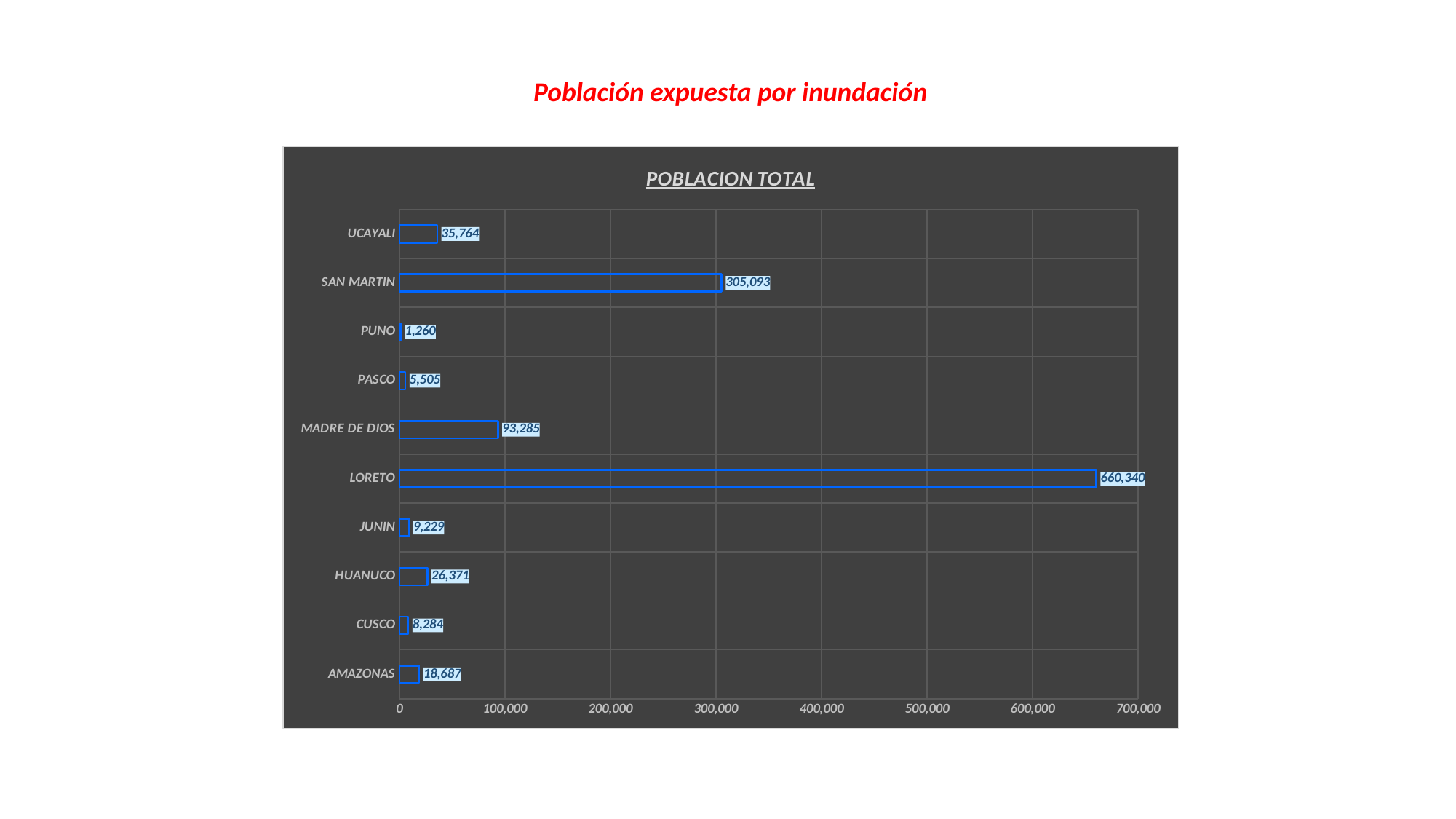
Which category has the lowest value? PUNO What is the value for PUNO? 1,260 Which category has the highest value? LORETO How many categories are shown in the chart? 10 What is the value for MADRE DE DIOS? 93,285 What is the value for SAN MARTIN? 305,093 What is the difference between the values for LORETO and SAN MARTIN? 355,247 Is the value for SAN MARTIN greater or less than 300,000? greater Which is larger, the value for UCAYALI or the value for HUANUCO? UCAYALI What kind of chart is shown on the slide? bar chart What is the title of the chart? POBLACION TOTAL What is the value for LORETO? 660,340